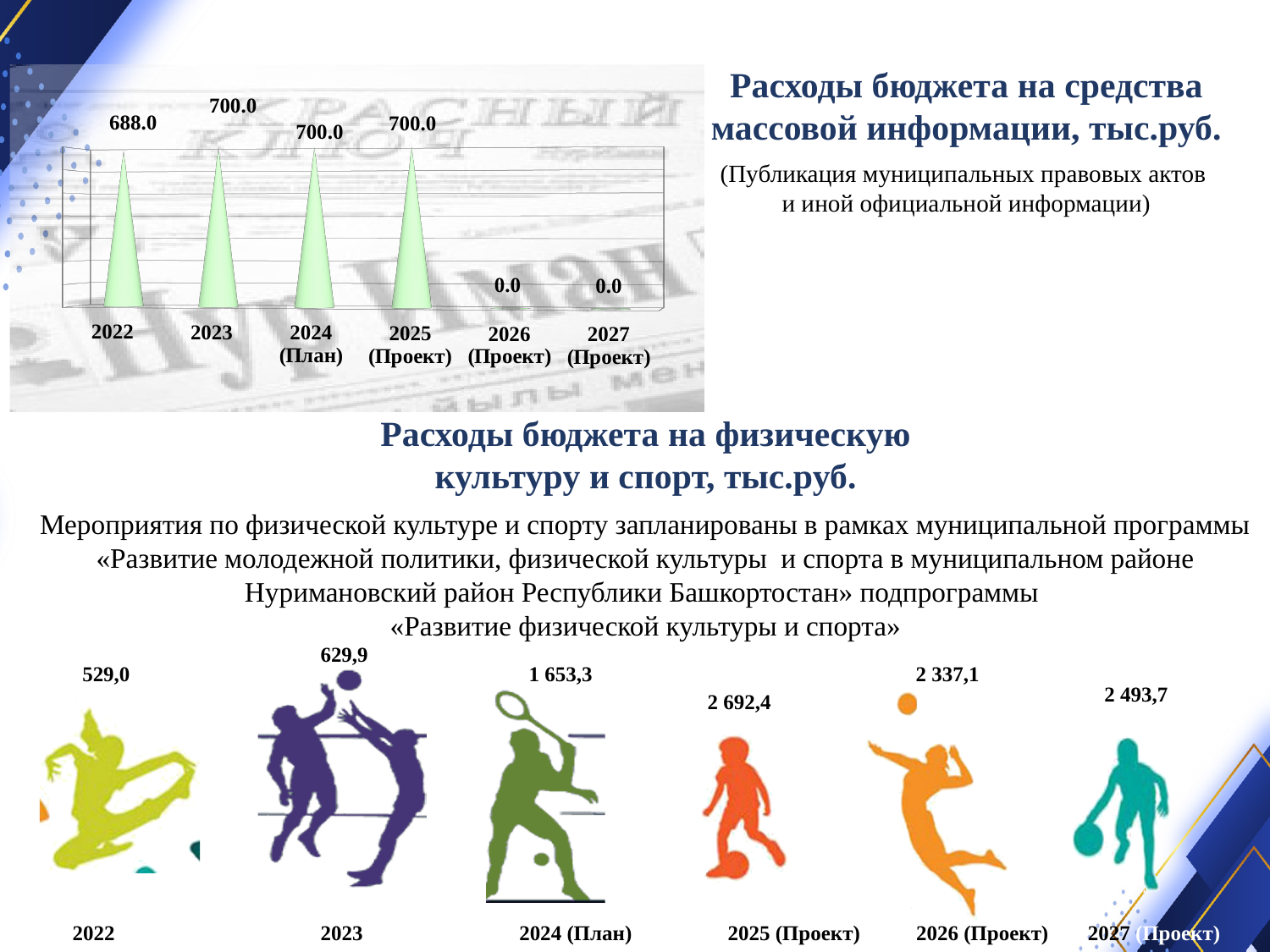
In the lower infographic titled «Расходы бюджета на физическую культуру и спорт, тыс.руб.», which year has the highest value? 2025 (Проект) In the lower infographic titled «Расходы бюджета на физическую культуру и спорт, тыс.руб.», which year has the lowest value? 2022 In the lower infographic titled «Расходы бюджета на физическую культуру и спорт, тыс.руб.», what is the difference between the values for 2023 and 2022? 100,9 In the chart titled «Расходы бюджета на средства массовой информации, тыс.руб.», what is the value for 2022? 688.0 In the chart titled «Расходы бюджета на средства массовой информации, тыс.руб.», what is the difference between the values for 2023 and 2022? 12.0 In the lower infographic titled «Расходы бюджета на физическую культуру и спорт, тыс.руб.», what is the value for 2024 (План)? 1 653,3 In the chart titled «Расходы бюджета на средства массовой информации, тыс.руб.», what is the value for 2024 (План)? 700.0 In the chart titled «Расходы бюджета на средства массовой информации, тыс.руб.», which is larger, the value for 2022 or the value for 2023? 2023 In the chart titled «Расходы бюджета на средства массовой информации, тыс.руб.», do the values rise or fall from 2025 (Проект) to 2027 (Проект)? fall In the chart titled «Расходы бюджета на средства массовой информации, тыс.руб.», what is the value for 2026 (Проект)? 0.0 In the chart titled «Расходы бюджета на средства массовой информации, тыс.руб.», how many categories are shown on the x axis? 6 What kind of chart is the one titled «Расходы бюджета на средства массовой информации, тыс.руб.»? bar chart